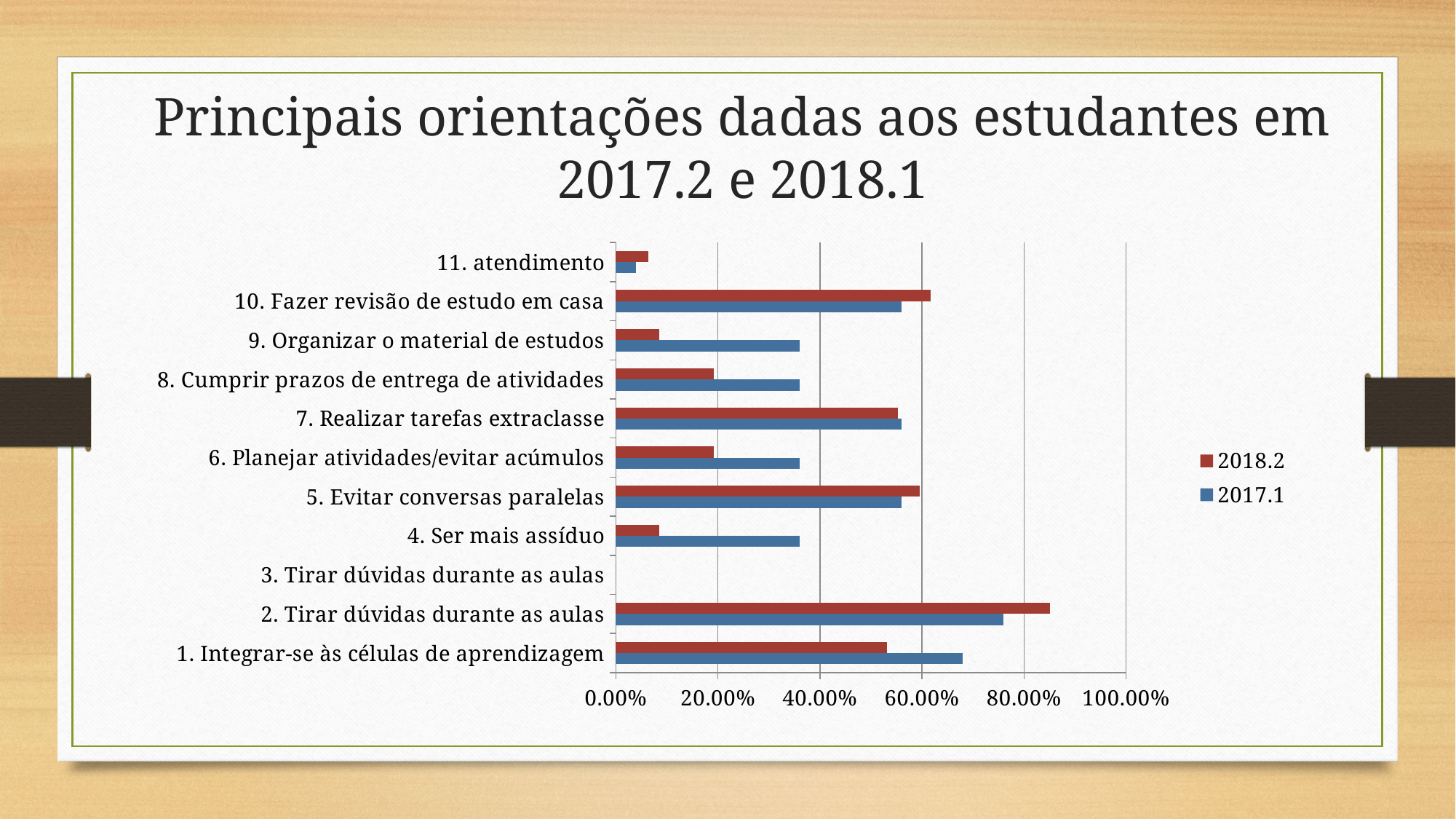
Is the 2017.1 value for '4. Ser mais assíduo' greater or less than 40.00%? less How many categories are listed on the vertical axis of the chart? 11 Is the 2018.2 value for '2. Tirar dúvidas durante as aulas' greater or less than 80.00%? greater What kind of chart is shown on the slide? Bar chart For '8. Cumprir prazos de entrega de atividades', which series has the larger value, 2017.1 or 2018.2? 2017.1 Which category has the highest value for the 2017.1 series? 2. Tirar dúvidas durante as aulas How many series does the legend list? 2 Is the 2017.1 value for '1. Integrar-se às células de aprendizagem' greater or less than 60.00%? greater Which colour represents the 2018.2 series in the legend? Red Which category has the highest value for the 2018.2 series? 2. Tirar dúvidas durante as aulas For '1. Integrar-se às células de aprendizagem', which series has the larger value, 2017.1 or 2018.2? 2017.1